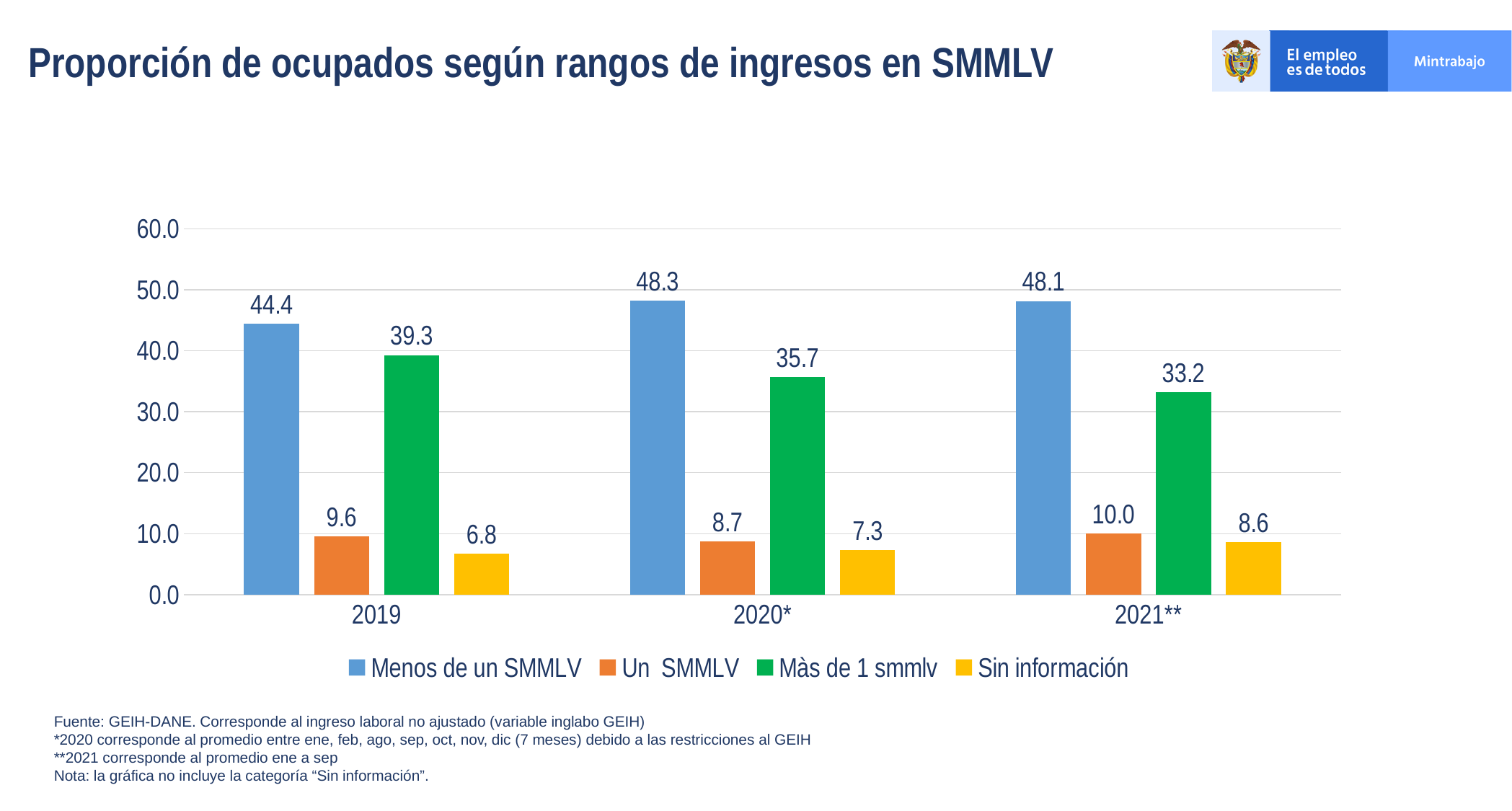
Which is larger: "Un SMMLV" in 2019 or "Un SMMLV" in 2020*? 2019 In which year is the "Menos de un SMMLV" series highest? 2020* Does the "Màs de 1 smmlv" series rise or fall from 2019 to 2021**? Fall What is the value for "Menos de un SMMLV" in 2019? 44.4 What is the value for "Màs de 1 smmlv" in 2021**? 33.2 How many year categories are shown on the x axis? 3 What is the value for "Un SMMLV" in 2021**? 10.0 In which year is the "Sin información" series lowest? 2019 What kind of chart is shown on the slide? Bar chart What is the difference between the "Màs de 1 smmlv" values for 2019 and 2021**? 6.1 How many series does the legend list? 4 What is the value for "Sin información" in 2020*? 7.3